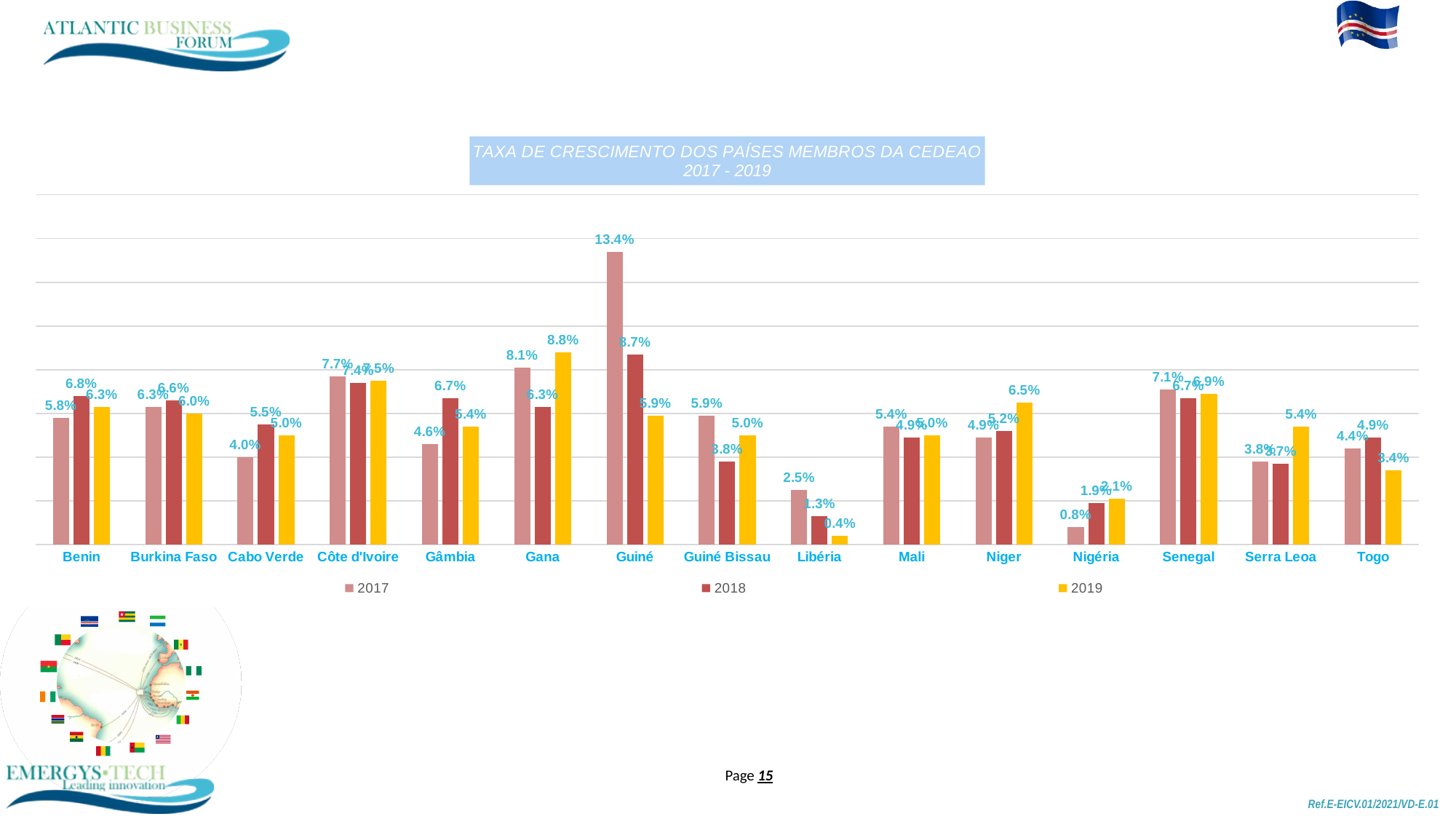
How many series does the legend list? 3 What was the growth rate for Guiné in 2017? 13.4% What kind of chart is shown on the slide? Bar chart Which country had the lowest growth rate in 2019? Libéria Did Libéria's growth rate rise or fall from 2017 to 2019? Fall Which country had the highest growth rate in 2017? Guiné What was the growth rate for Cabo Verde in 2019? 5.0% What was the growth rate for Nigéria in 2018? 1.9% What is the difference between Gana's 2019 and 2018 growth rates? 2.5% Which was higher for Senegal, the 2017 or the 2018 growth rate? 2017 How many countries are shown on the x axis? 15 Which colour represents the 2019 series in the legend? Yellow